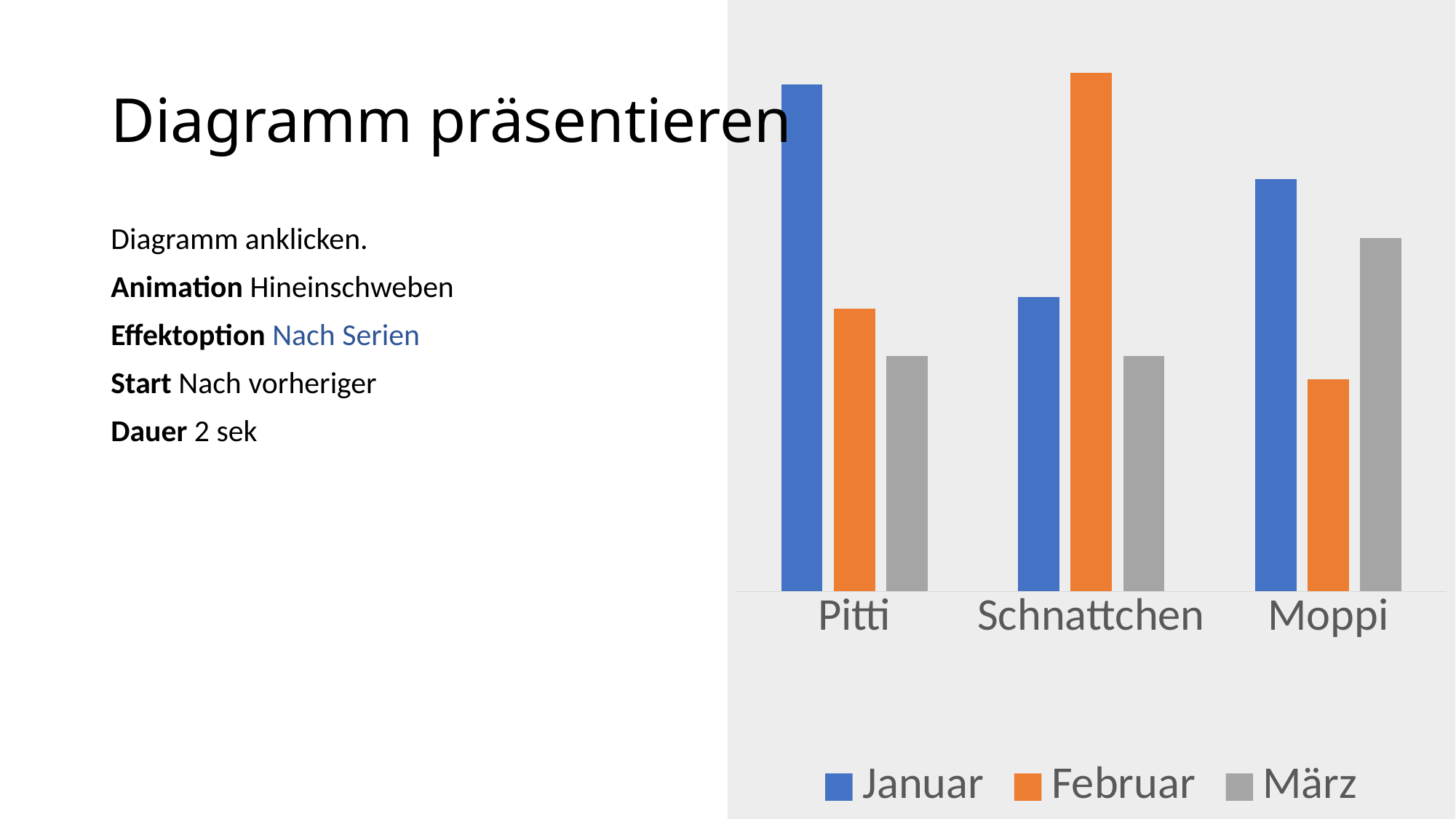
What are the entries listed in the chart's legend? Januar, Februar, März For Pitti, which is larger: the Januar value or the Februar value? Januar What colour represents the Februar series in the chart? orange Which category has the lowest value for the Januar series? Schnattchen How many categories are shown on the x axis of the chart? 3 Which category has the lowest value for the Februar series? Moppi What kind of chart is shown on the slide? bar chart For Moppi, which is larger: the Februar value or the März value? März Which category has the highest value for the Februar series? Schnattchen Which category has the highest value for the Januar series? Pitti Which category has the highest value for the März series? Moppi How many series does the chart's legend list? 3